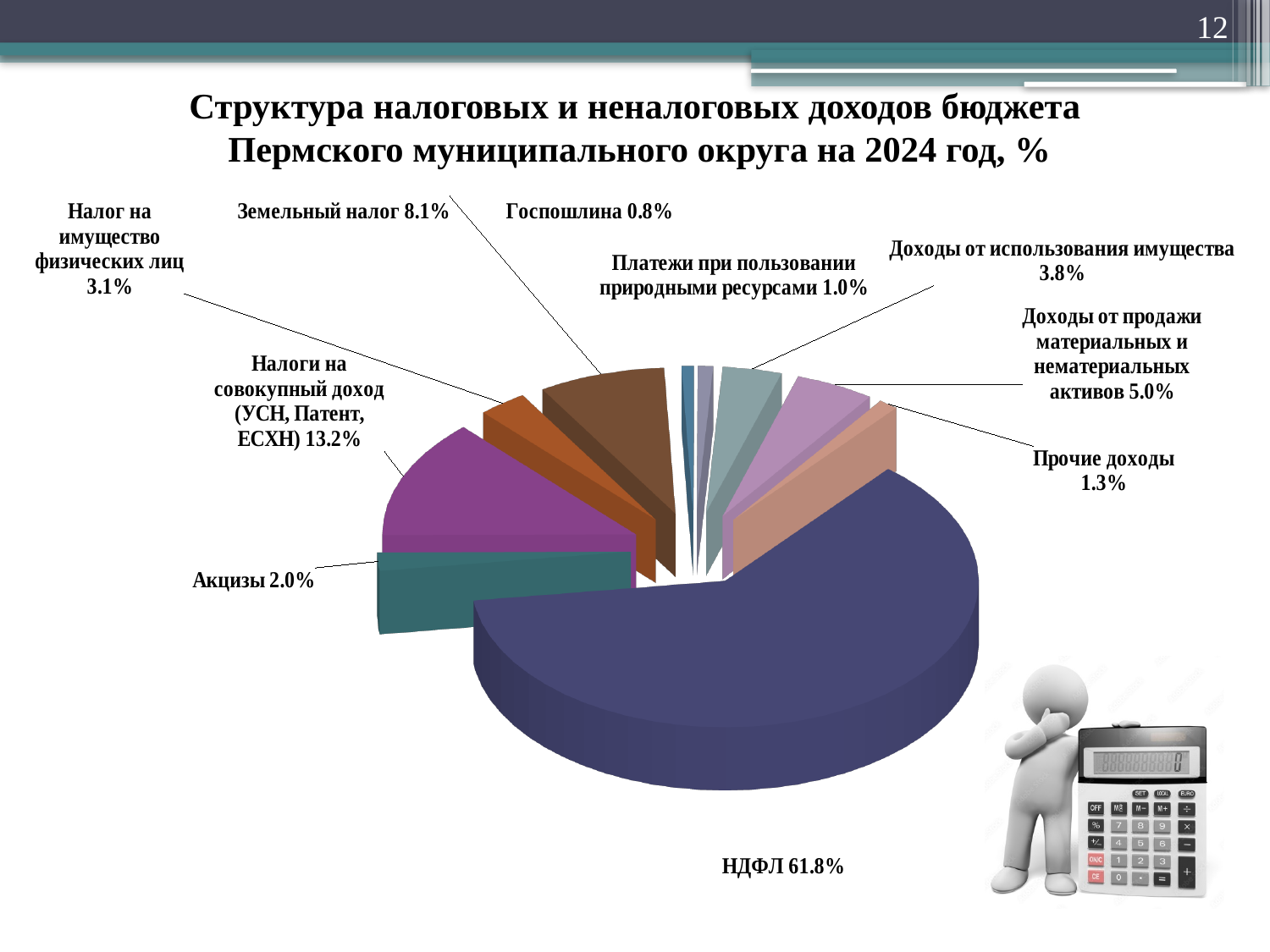
How many slices does the pie chart have? 10 What is the value shown for Земельный налог? 8.1% What share of the budget revenue does НДФЛ account for? 61.8% What is the title of the chart? Структура налоговых и неналоговых доходов бюджета Пермского муниципального округа на 2024 год, % What is the value shown for Акцизы? 2.0% Which category has the smallest share of the pie? Госпошлина Which is larger: Доходы от использования имущества or Налог на имущество физических лиц? Доходы от использования имущества What kind of chart is shown on the slide? Pie chart What is the difference between the shares of НДФЛ and Налоги на совокупный доход (УСН, Патент, ЕСХН)? 48.6% What is the value shown for Доходы от продажи материальных и нематериальных активов? 5.0% Which category has the largest share of the pie? НДФЛ What is the value shown for Налоги на совокупный доход (УСН, Патент, ЕСХН)? 13.2%